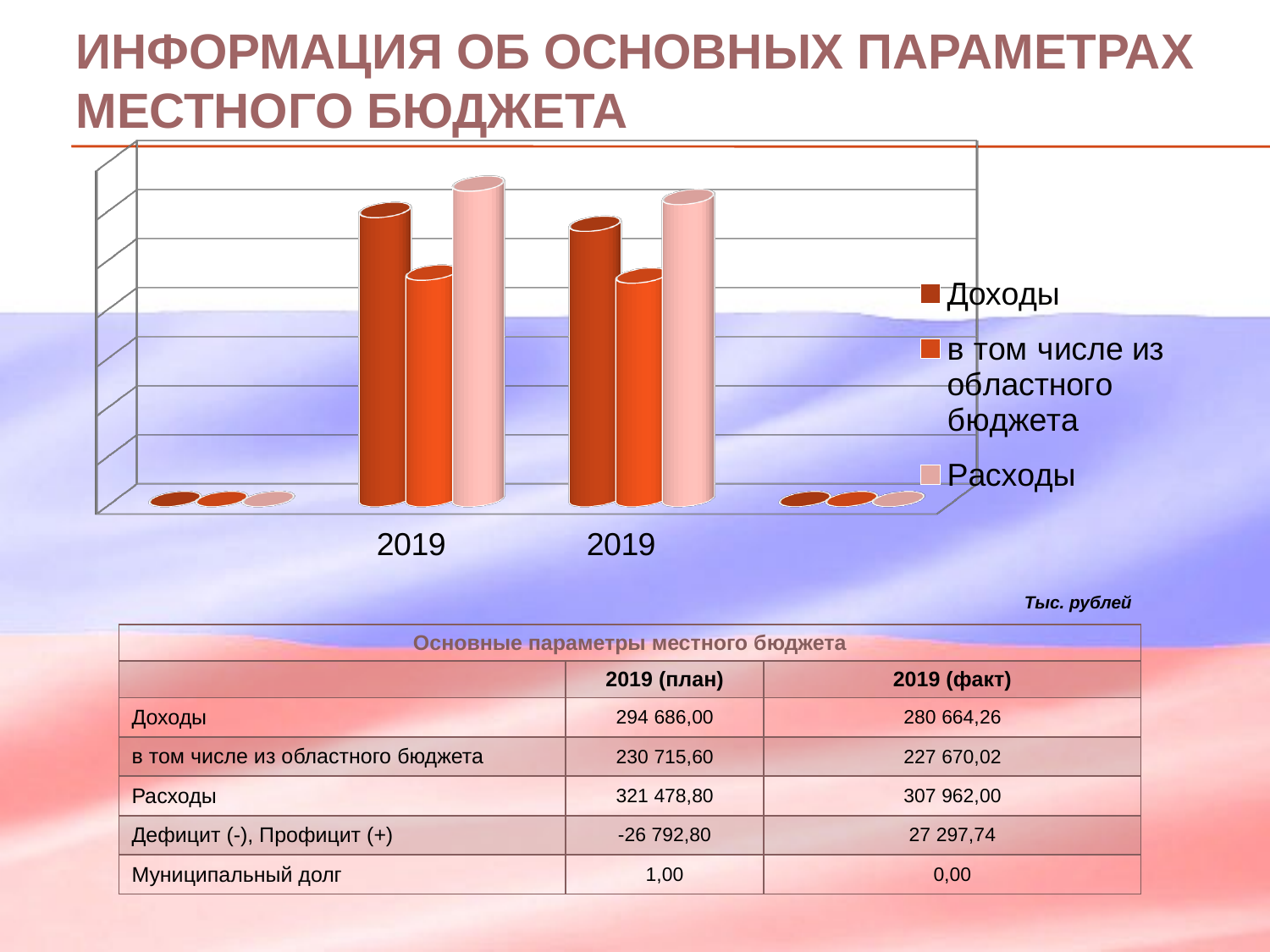
In the right group of bars, which series has the shortest bar? в том числе из областного бюджета What kind of chart is shown on the slide? bar chart What are the three series named in the chart legend? Доходы, в том числе из областного бюджета, Расходы In the right group of bars, which series has the tallest bar? Расходы How many series does the chart legend list? 3 In the left group of bars, which is larger: Доходы or Расходы? Расходы In the right group of bars, which is larger: Доходы or в том числе из областного бюджета? Доходы In the left group of bars, which series has the tallest bar? Расходы Does the Доходы bar rise or fall from the left group to the right group? fall What category label appears under both groups of bars on the x axis? 2019 In the left group of bars, which series has the shortest bar? в том числе из областного бюджета